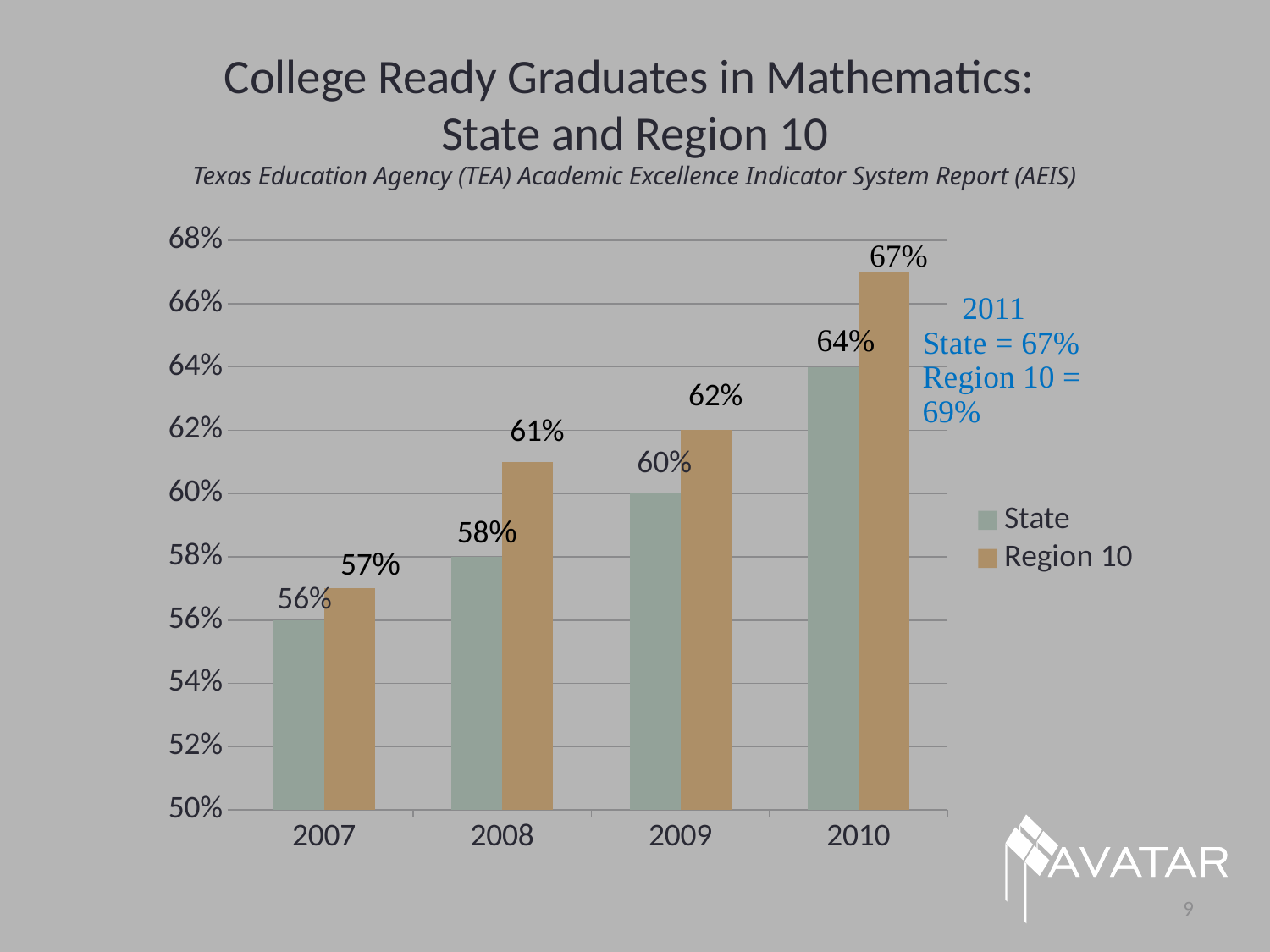
What are the two series listed in the legend? State and Region 10 How many years are shown on the x axis? 4 What kind of chart is shown? Bar chart Do the State values rise or fall from 2007 to 2010? Rise Which year has the highest State value? 2010 What is the difference between the Region 10 and State values in 2010? 3% What is the Region 10 value for 2010? 67% How many series does the legend list? 2 Which is larger in 2007, the State value or the Region 10 value? Region 10 What is the Region 10 value for 2009? 62% What is the State value for 2008? 58% Which year has the lowest Region 10 value? 2007